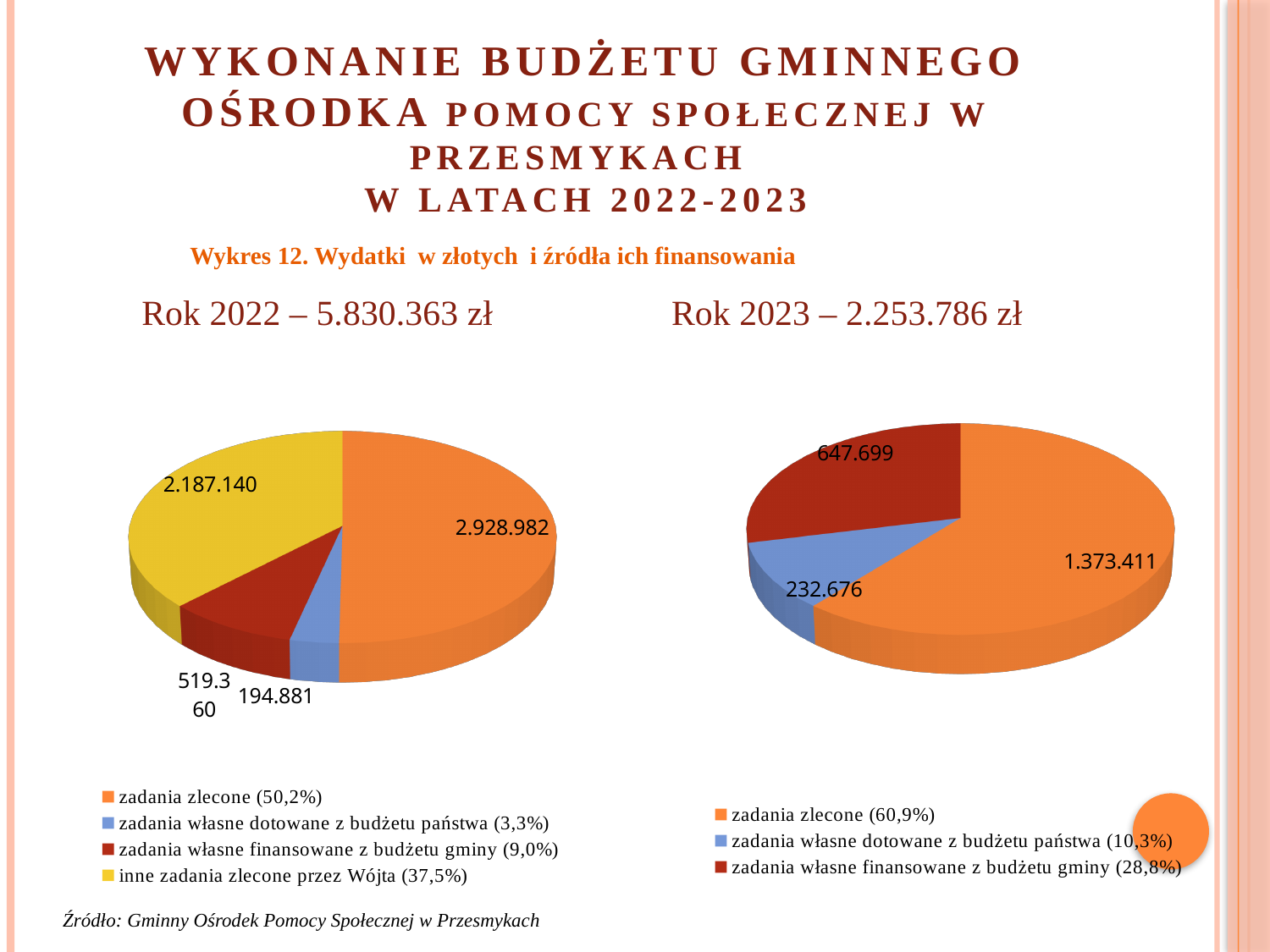
In the Rok 2022 chart, what is the value for zadania własne dotowane z budżetu państwa? 194.881 In the Rok 2023 chart, what is the value for zadania własne dotowane z budżetu państwa? 232.676 In the Rok 2022 chart, what is the value for inne zadania zlecone przez Wójta? 2.187.140 How many categories does the Rok 2022 legend list? 4 In the Rok 2022 chart, what is the value for zadania zlecone? 2.928.982 What kind of chart is used for Rok 2022? pie chart In the Rok 2023 chart, what is the value for zadania własne finansowane z budżetu gminy? 647.699 In the Rok 2022 chart, which category has the smallest slice? zadania własne dotowane z budżetu państwa In the Rok 2023 chart, what is the difference between zadania własne finansowane z budżetu gminy and zadania własne dotowane z budżetu państwa? 415.023 In the Rok 2023 chart, what share of the pie does zadania zlecone have? 60,9% In the Rok 2022 chart, what share of the pie does inne zadania zlecone przez Wójta have? 37,5% In the Rok 2023 chart, which category has the largest slice? zadania zlecone